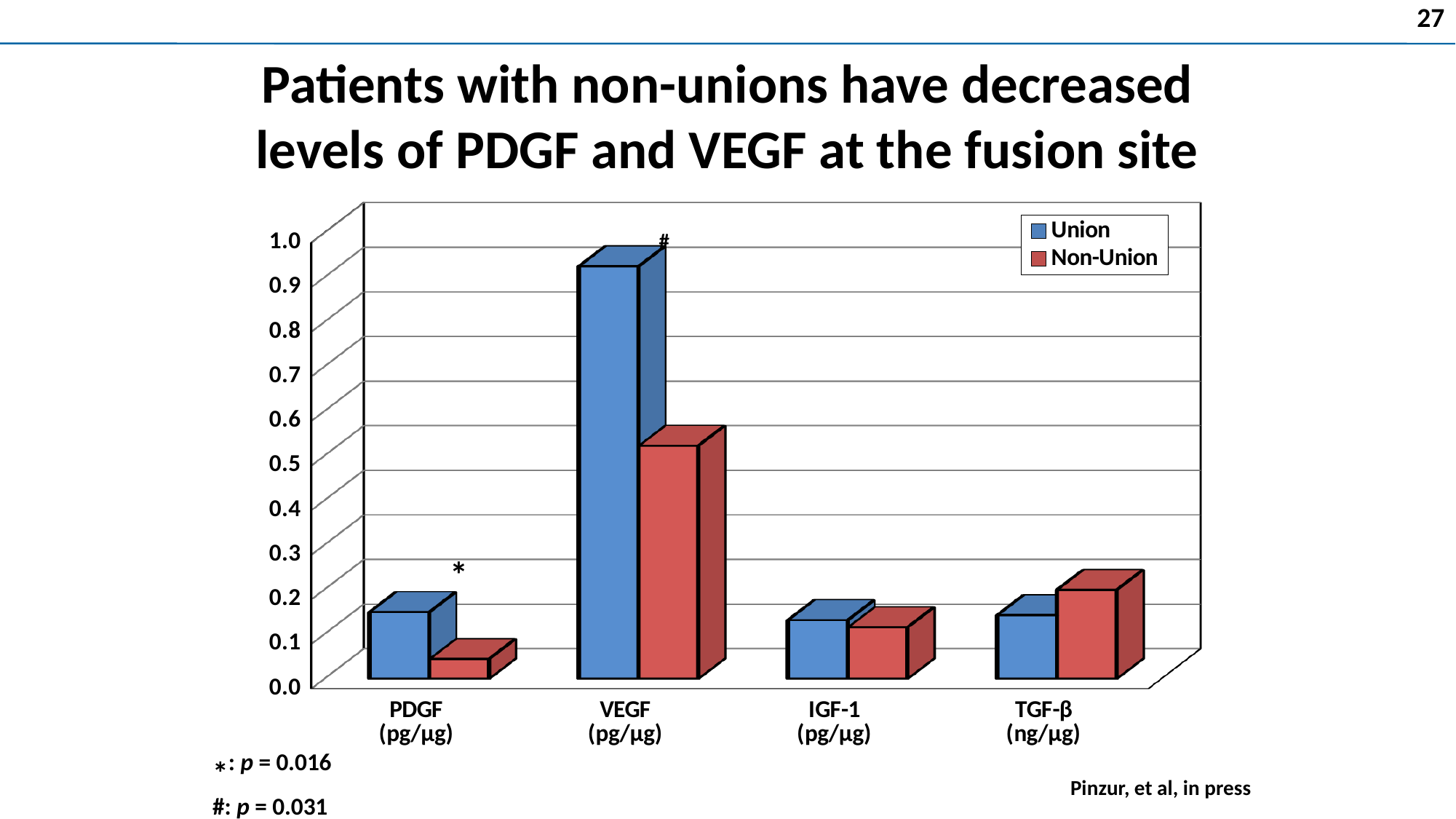
What kind of chart is shown on the slide? bar chart Is the Non-Union value for PDGF greater or less than 0.2? less Is the Non-Union value for VEGF greater or less than 0.4? greater For TGF-β, which is larger: the Union value or the Non-Union value? Non-Union For which growth factor is the Non-Union bar the lowest? PDGF For VEGF, which is larger: the Union value or the Non-Union value? Union What unit is shown for TGF-β on the x axis? ng/µg How many series does the legend list? 2 How many growth factor categories are shown on the x axis? 4 Which series are listed in the legend? Union and Non-Union Is the Union value for VEGF greater or less than 0.8? greater For which growth factor is the Union bar the highest? VEGF